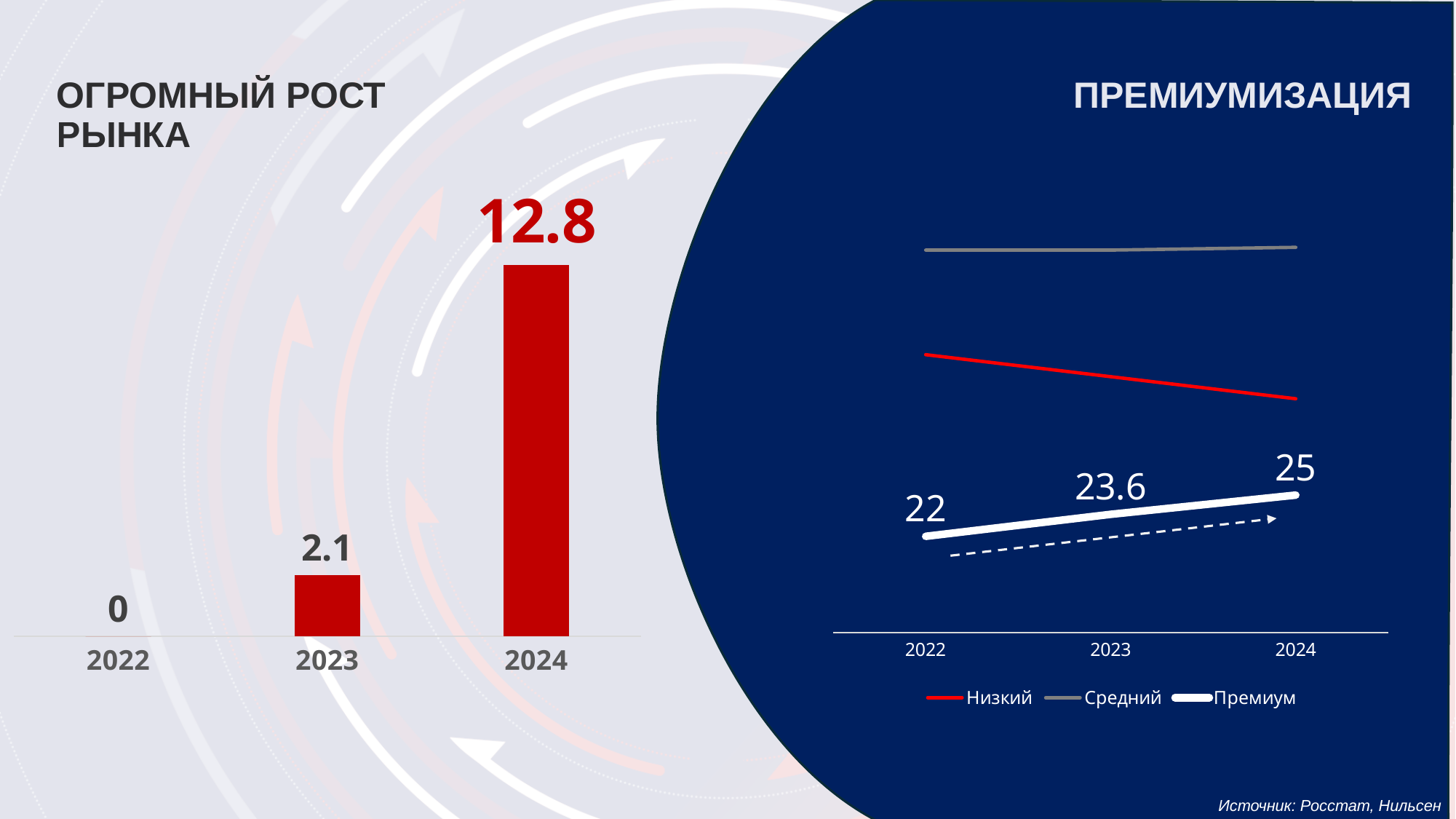
In the bar chart titled ОГРОМНЫЙ РОСТ РЫНКА, what is the value for 2022? 0 In the line chart titled ПРЕМИУМИЗАЦИЯ, what colour is the Низкий series line? red In the bar chart titled ОГРОМНЫЙ РОСТ РЫНКА, how many years are shown on the x axis? 3 In the bar chart titled ОГРОМНЫЙ РОСТ РЫНКА, what is the difference between the 2024 and 2023 values? 10.7 In the line chart titled ПРЕМИУМИЗАЦИЯ, what is the value of the Премиум series in 2024? 25 In the bar chart titled ОГРОМНЫЙ РОСТ РЫНКА, what is the value for 2024? 12.8 In the line chart titled ПРЕМИУМИЗАЦИЯ, does the Низкий series rise or fall from 2022 to 2024? fall What kind of chart is the one titled ОГРОМНЫЙ РОСТ РЫНКА? bar chart In the bar chart titled ОГРОМНЫЙ РОСТ РЫНКА, what is the value for 2023? 2.1 In the line chart titled ПРЕМИУМИЗАЦИЯ, how many series does the legend list? 3 In the bar chart titled ОГРОМНЫЙ РОСТ РЫНКА, which year has the highest value? 2024 In the line chart titled ПРЕМИУМИЗАЦИЯ, what is the value of the Премиум series in 2023? 23.6